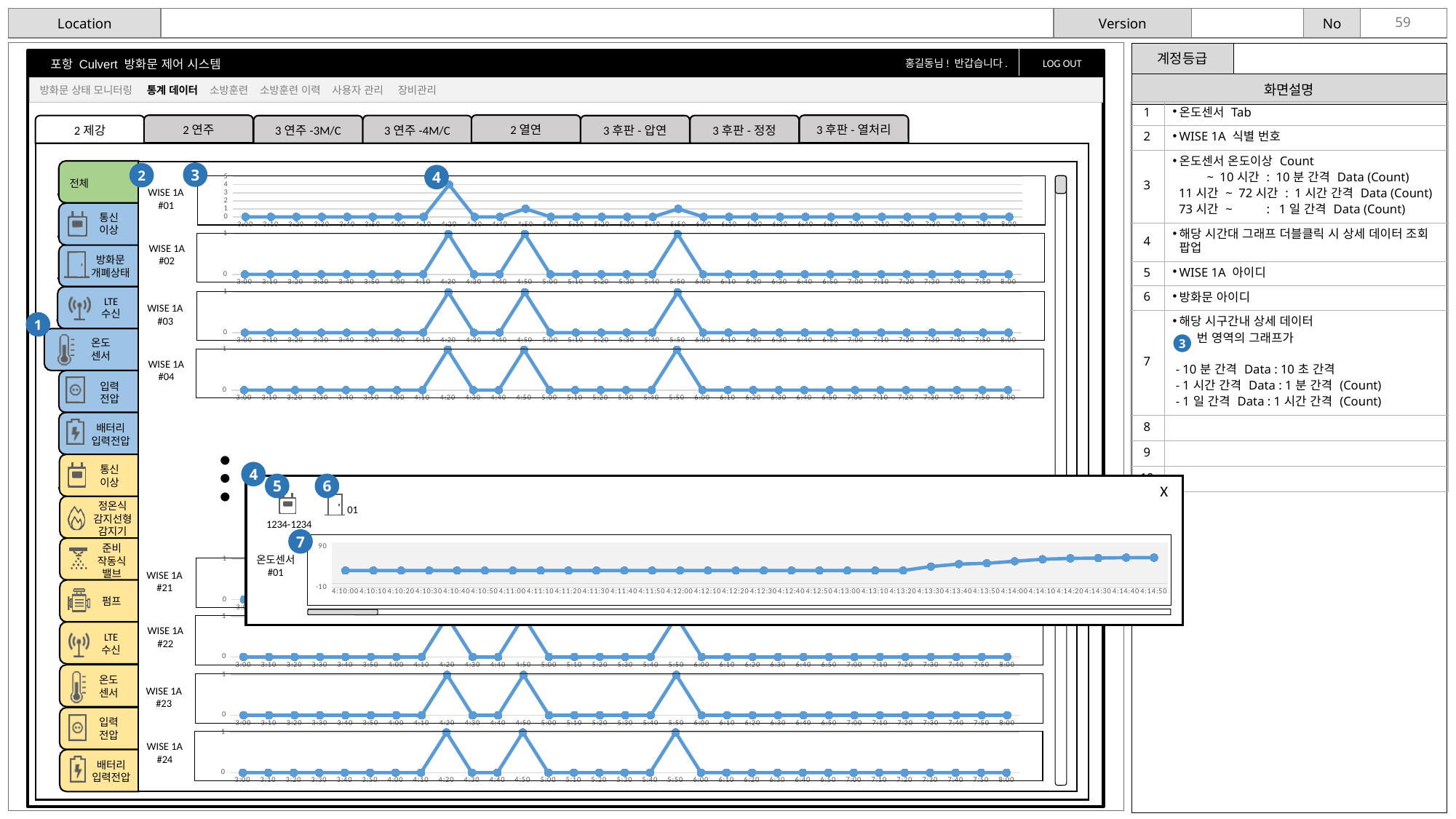
In the WISE 1A #24 chart, what is the difference between the value at 5:50 and the value at 6:00? 1 In the WISE 1A #01 chart, at which time is the value highest? 4:20 What kind of chart is used for WISE 1A #02? line chart In the WISE 1A #01 chart, is the value at 6:00 greater or less than 3? less What is the first time label on the x axis of the WISE 1A #22 chart? 3:00 In the WISE 1A #03 chart, what is the value at 3:00? 0 In the WISE 1A #01 chart, is the value at 4:20 greater or less than 3? greater In the WISE 1A #04 chart, which is larger, the value at 4:50 or the value at 5:00? 4:50 In the popup chart labelled 온도센서 #01, do the values rise or fall toward the right end of the x axis? rise In the popup chart labelled 온도센서 #01, what is the highest value shown on the y axis? 90 What is the last time label on the x axis of the WISE 1A #23 chart? 8:00 In the WISE 1A #02 chart, what is the value at 4:20? 1